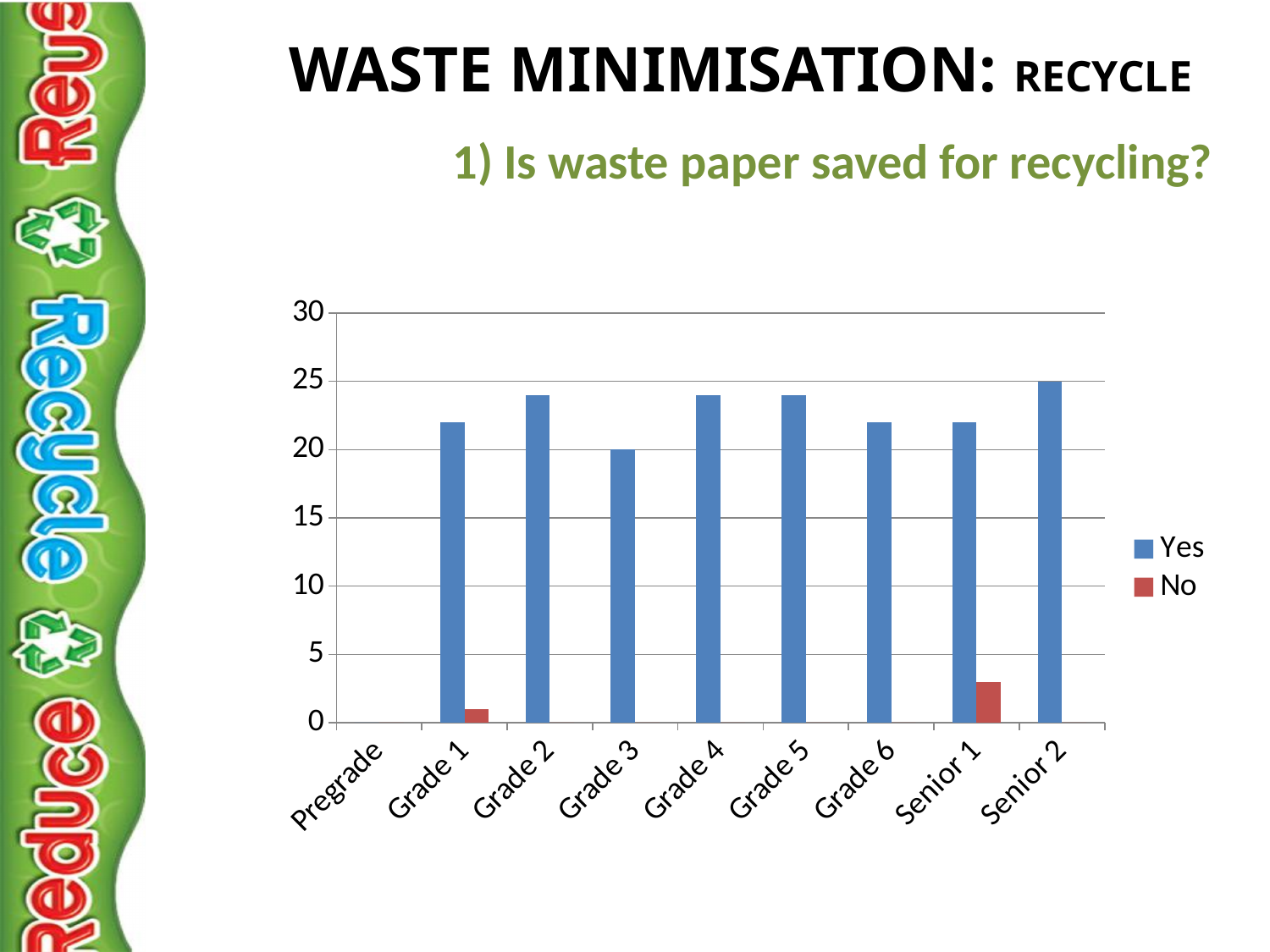
What are the two series named in the legend? Yes and No Which is larger, the Yes value for Grade 1 or the Yes value for Grade 3? Grade 1 Is the Yes value for Grade 1 greater or less than 20? greater How many categories are shown along the x axis? 9 What is the Yes value for Senior 2? 25 Which categories show a No bar? Grade 1 and Senior 1 Is the Yes value for Grade 6 greater or less than 25? less Is the No value for Senior 1 greater or less than 5? less What type of chart is shown on the slide? bar chart Which category has the highest Yes value? Senior 2 What is the Yes value for Grade 3? 20 How many series does the legend list? 2